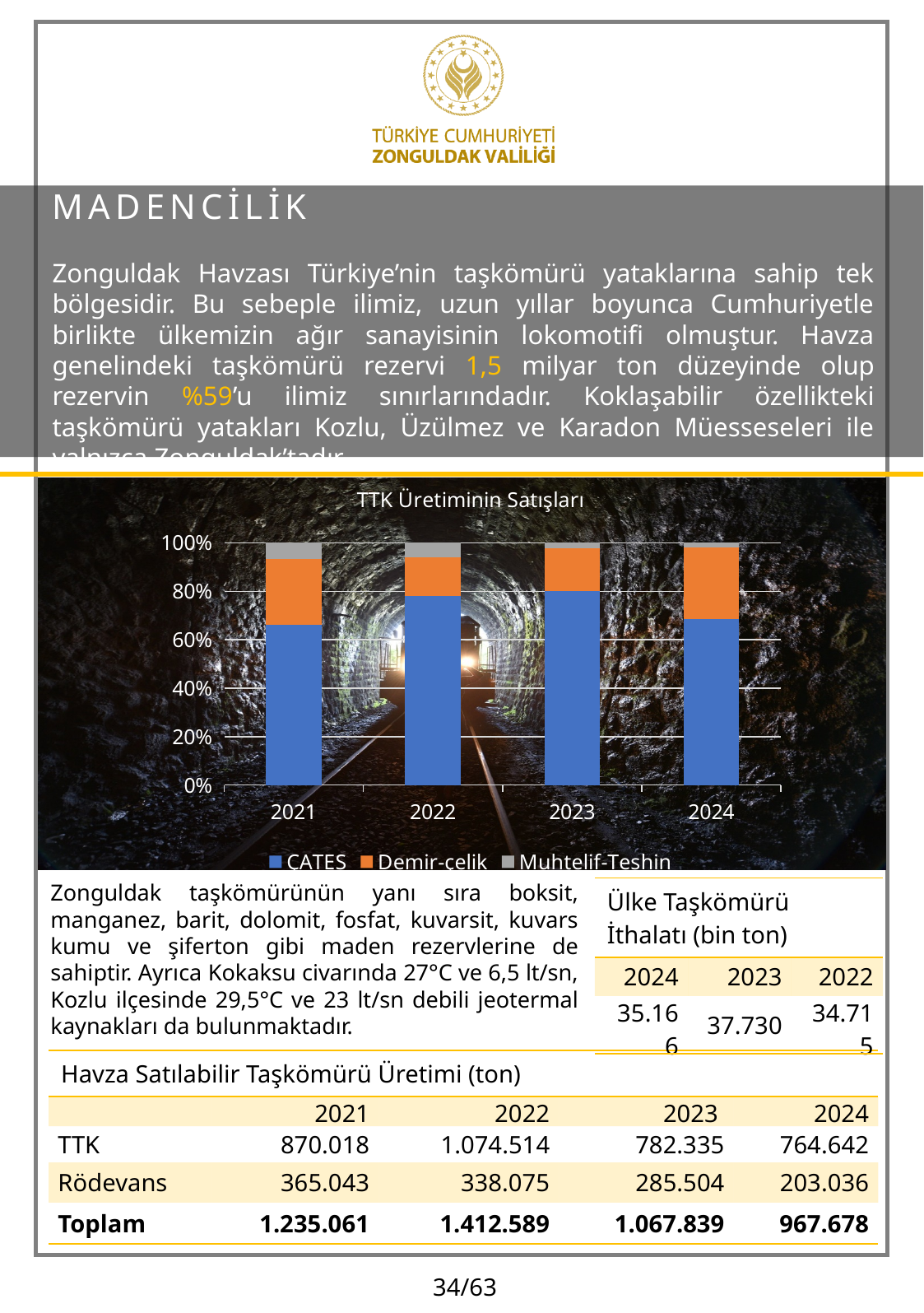
Is the ÇATES share for 2022 greater or less than 60%? greater Which series is shown in blue in the chart? ÇATES Is the ÇATES share for 2021 greater or less than 60%? greater Which year has the larger ÇATES share, 2023 or 2024? 2023 Which year has the larger ÇATES share, 2021 or 2022? 2022 How many series does the chart legend list? 3 What kind of chart is shown on the slide? stacked bar chart Is the ÇATES share for 2024 greater or less than 80%? less What does each stacked bar in the chart add up to? 100% How many years are shown on the x axis of the chart? 4 What is the title of the chart? TTK Üretiminin Satışları